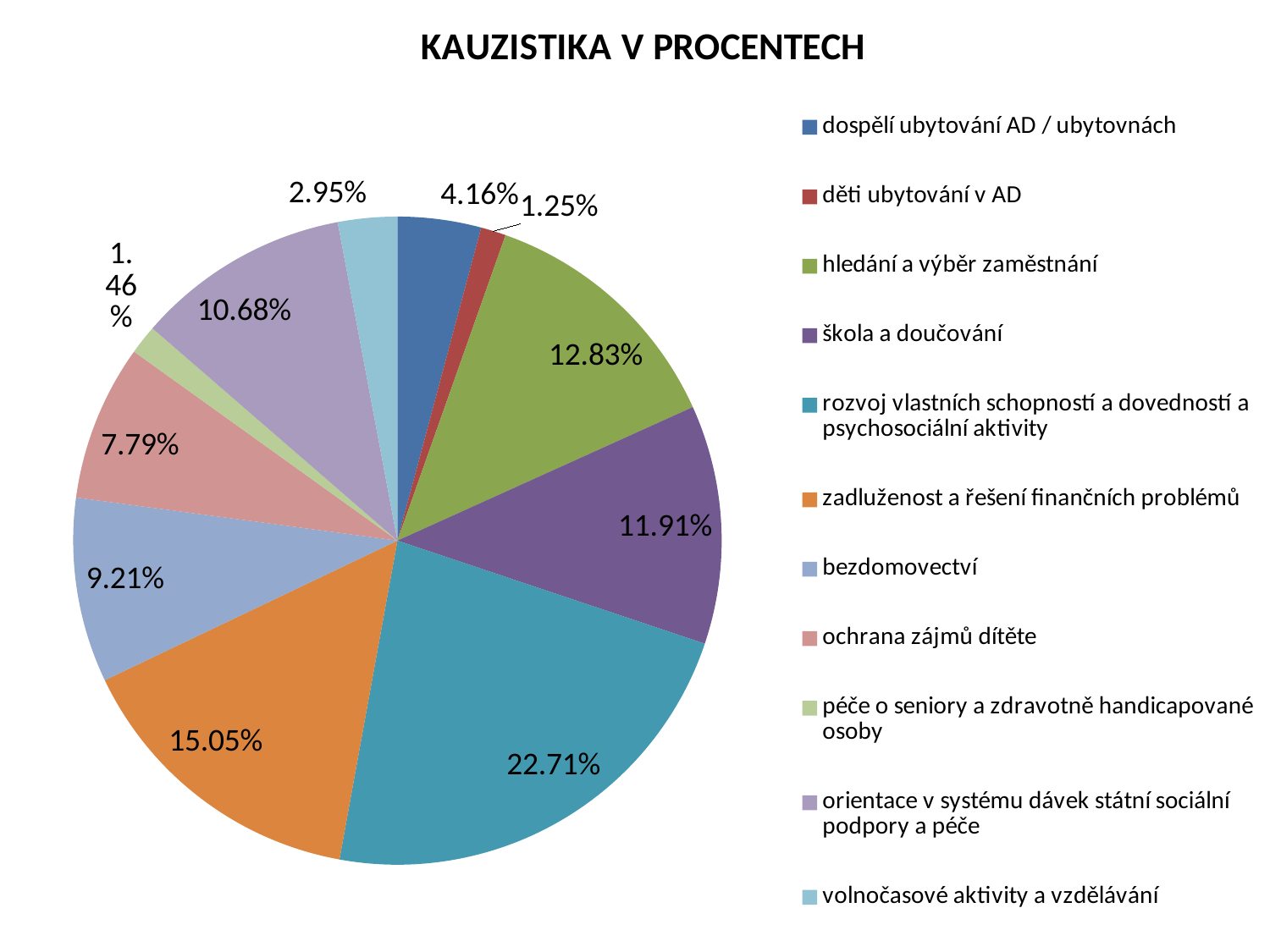
What percentage is shown for "rozvoj vlastních schopností a dovedností a psychosociální aktivity"? 22.71% What is the title of the chart? KAUZISTIKA V PROCENTECH What percentage is shown for "zadluženost a řešení finančních problémů"? 15.05% What type of chart is shown on the slide? pie chart Which is larger: the share for "orientace v systému dávek státní sociální podpory a péče" or the share for "ochrana zájmů dítěte"? orientace v systému dávek státní sociální podpory a péče Which category has the smallest share of the pie? děti ubytování v AD What is the combined share of "dospělí ubytování AD / ubytovnách" and "děti ubytování v AD"? 5.41% What percentage is shown for "bezdomovectví"? 9.21% Which category has the largest share of the pie? rozvoj vlastních schopností a dovedností a psychosociální aktivity What is the difference between the shares for "hledání a výběr zaměstnání" and "škola a doučování"? 0.92% What percentage is shown for "volnočasové aktivity a vzdělávání"? 2.95% How many categories does the legend list? 11